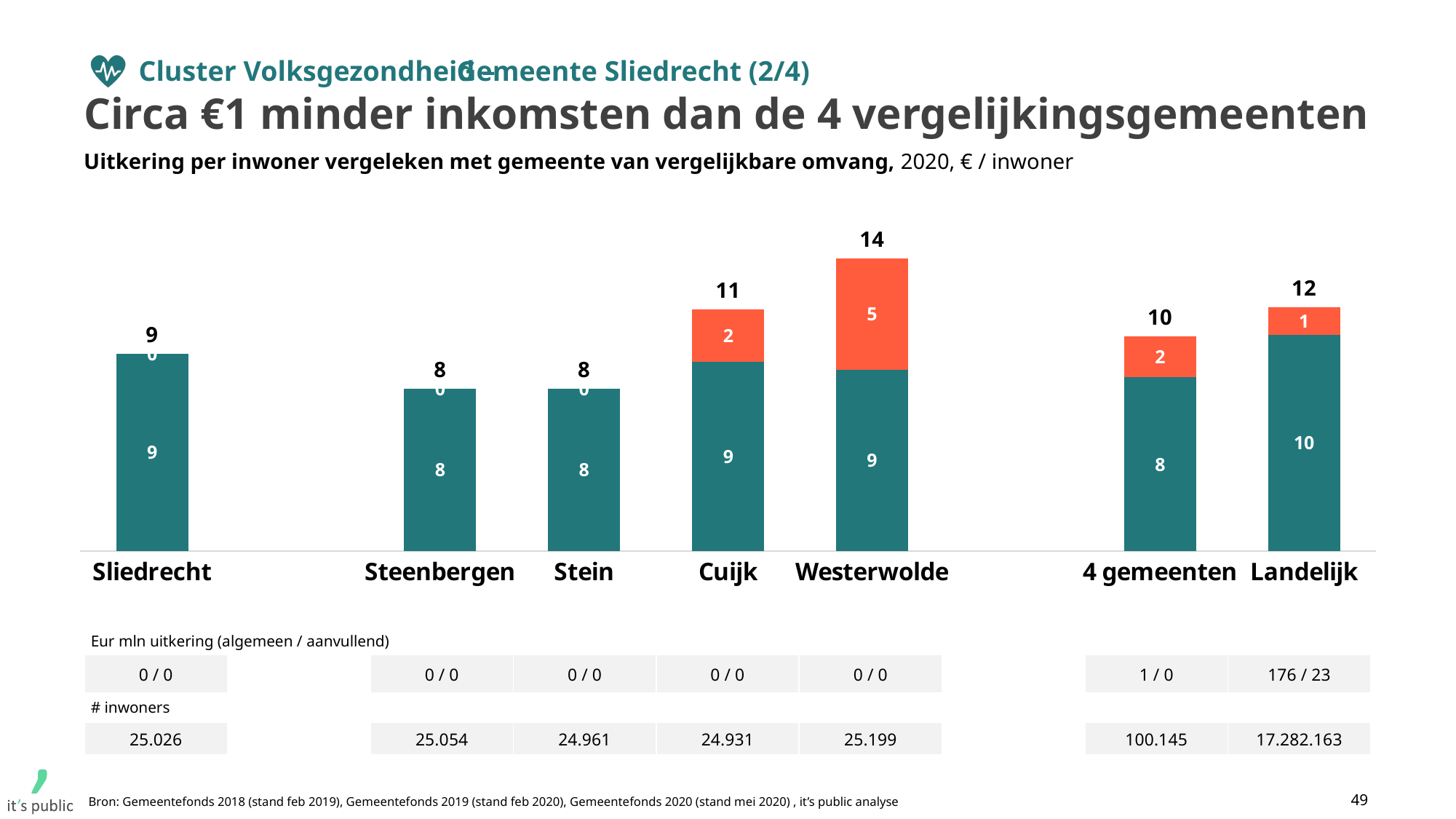
Which category has the highest total value? Westerwolde How many categories are shown on the x axis of the chart? 7 What is the total of the stacked bar for 4 gemeenten? 10 What is the total value shown above the bar for Sliedrecht? 9 What kind of chart is shown on the slide? Stacked bar chart What is the value of the orange (top) segment of the Westerwolde bar? 5 What is the difference between the total for Westerwolde and the total for Sliedrecht? 5 What is the difference between the total for 4 gemeenten and the total for Sliedrecht? 1 What is the value of the teal (bottom) segment of the Landelijk bar? 10 What is the total value shown above the bar for Westerwolde? 14 What is the value of the orange (top) segment of the Cuijk bar? 2 Which is larger, the total for Cuijk or the total for Landelijk? Landelijk